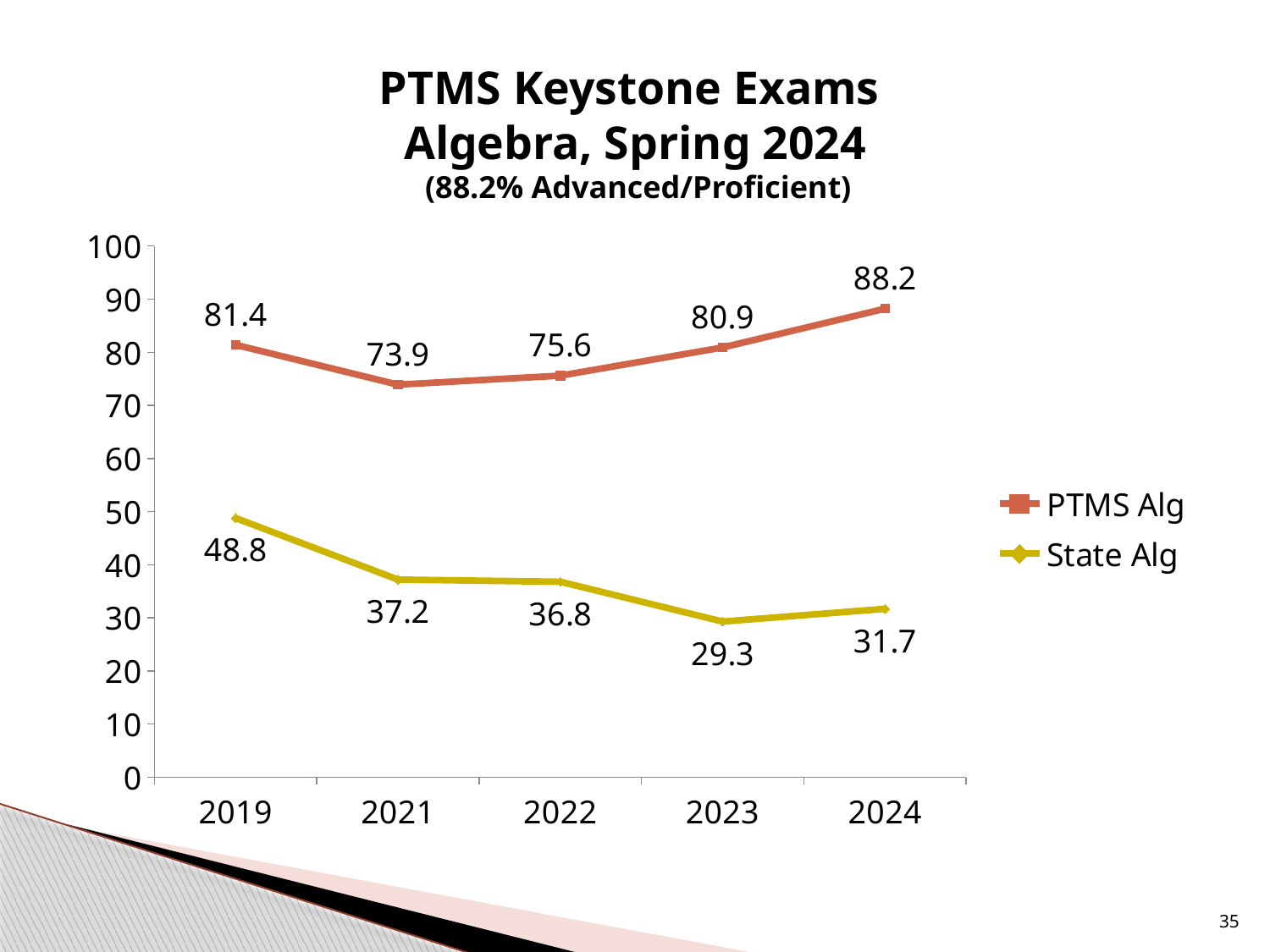
What is the difference between the PTMS Alg and State Alg values in 2024? 56.5 How many years are shown on the x axis? 5 Which is larger, the PTMS Alg value in 2021 or in 2022? 2022 In which year is the State Alg value lowest? 2023 Does the State Alg line rise or fall from 2019 to 2023? fall What is the State Alg value for 2021? 37.2 How many series does the legend list? 2 What is the PTMS Alg value for 2019? 81.4 What kind of chart is shown on the slide? line chart What is the PTMS Alg value for 2024? 88.2 What is the title of the chart? PTMS Keystone Exams Algebra, Spring 2024 In which year is the PTMS Alg value highest? 2024